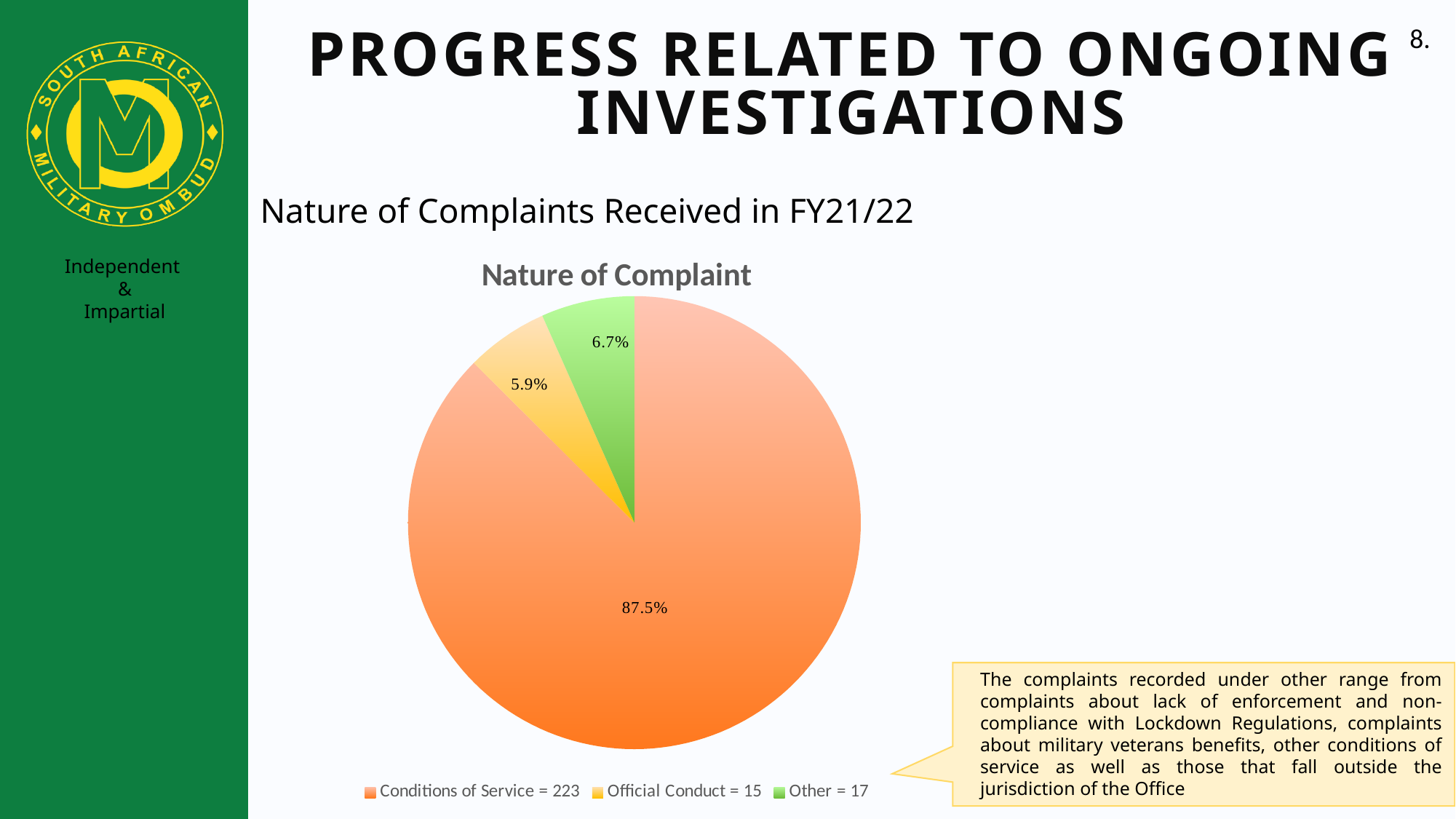
What is the title of the chart? Nature of Complaint Which category has the largest share of the pie? Conditions of Service How many slices does the pie chart have? 3 What is the difference in number of complaints between Other and Official Conduct? 2 What percentage of the pie does Conditions of Service represent? 87.5% Which category has the smallest share of the pie? Official Conduct What type of chart is shown on the slide? Pie chart How many complaints are recorded under Conditions of Service according to the legend? 223 Which colour represents the Other category in the pie chart? Green How many complaints are recorded under Official Conduct according to the legend? 15 What percentage of the pie does Official Conduct represent? 5.9% What percentage of the pie does Other represent? 6.7%